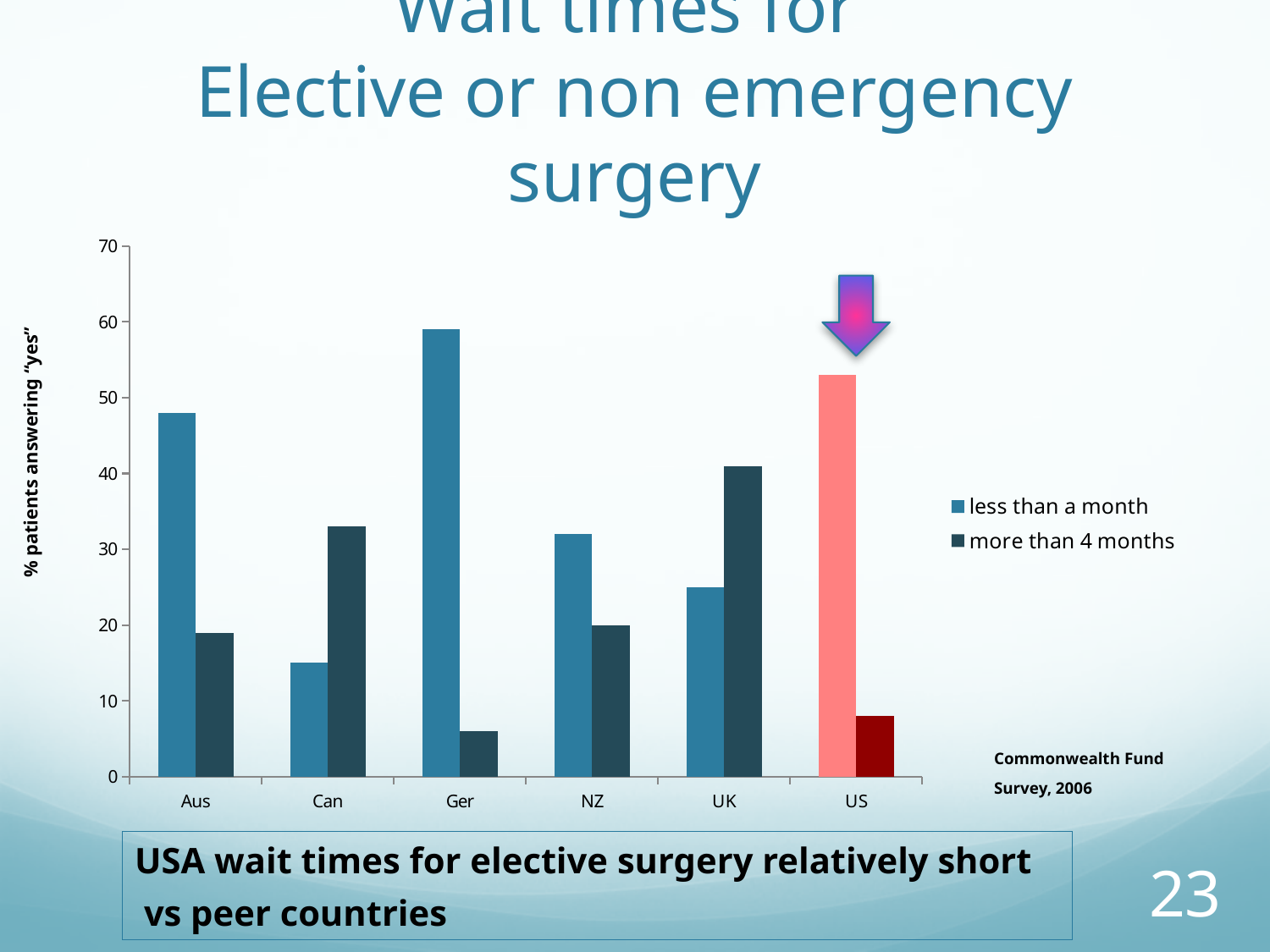
Which country has the highest value for "less than a month"? Ger Is the "less than a month" value for Ger greater or less than 50? greater What is the label on the y axis of the chart? % patients answering "yes" How many countries are shown on the x axis of the chart? 6 Is the "less than a month" value for Aus greater or less than 40? greater Is the "less than a month" value for Can greater or less than 20? less What kind of chart is shown on the slide? bar chart Which country has the lowest value for "less than a month"? Can For the UK, which is larger: the "less than a month" value or the "more than 4 months" value? more than 4 months How many series does the chart's legend list? 2 Which country has the highest value for "more than 4 months"? UK